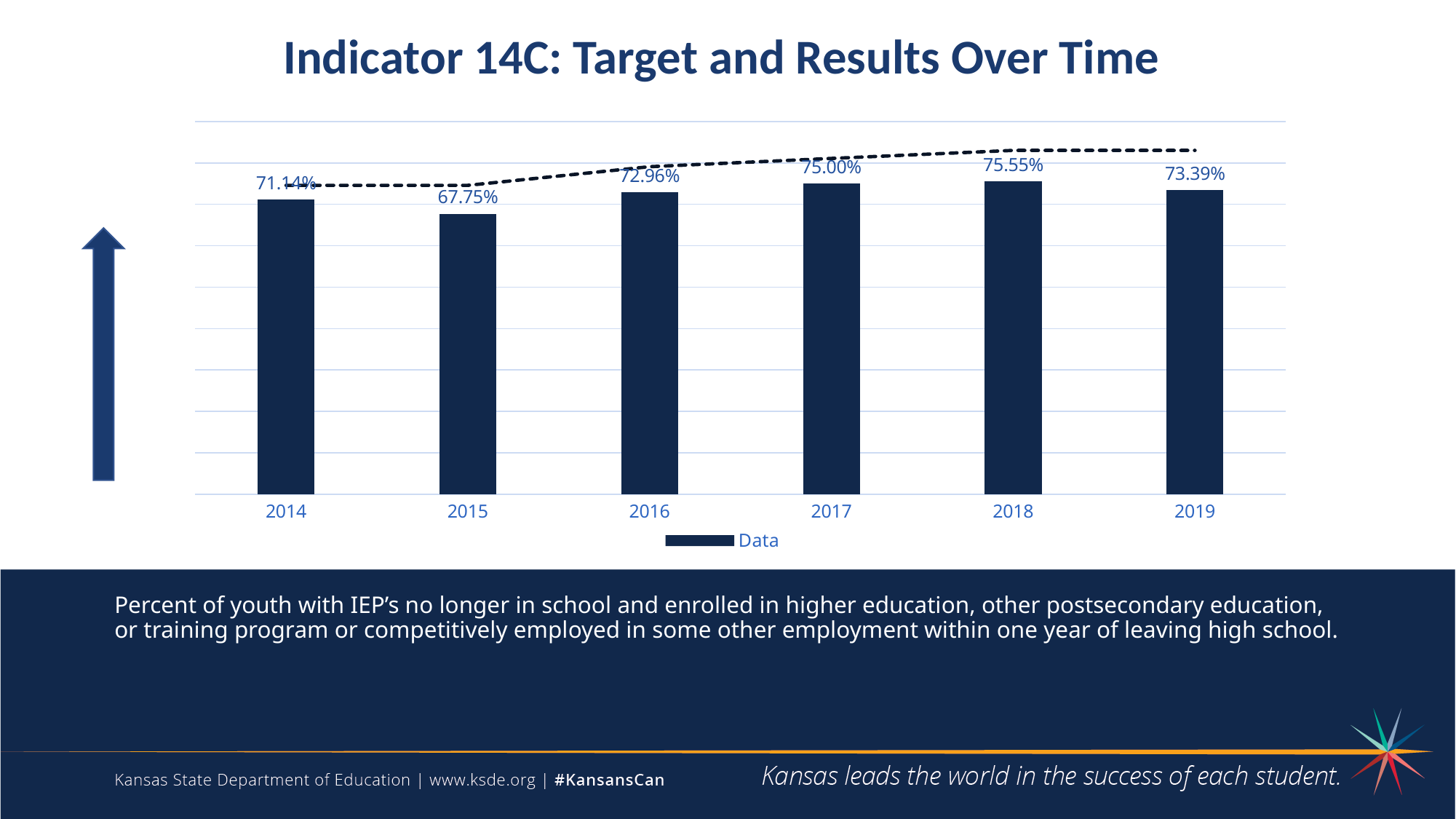
How many years are shown on the x axis? 6 Which year has the highest value? 2018 Which is larger, the value for 2019 or the value for 2016? 2019 Which year has the lowest value? 2015 What is the value for 2017? 75.00% What kind of chart is shown on the slide? combination bar and line chart What is the value for 2016? 72.96% What is the value for 2018? 75.55% What is the value for 2015? 67.75% What is the difference between the values for 2018 and 2015? 7.80% What is the value for 2019? 73.39% How many series does the legend list? 1